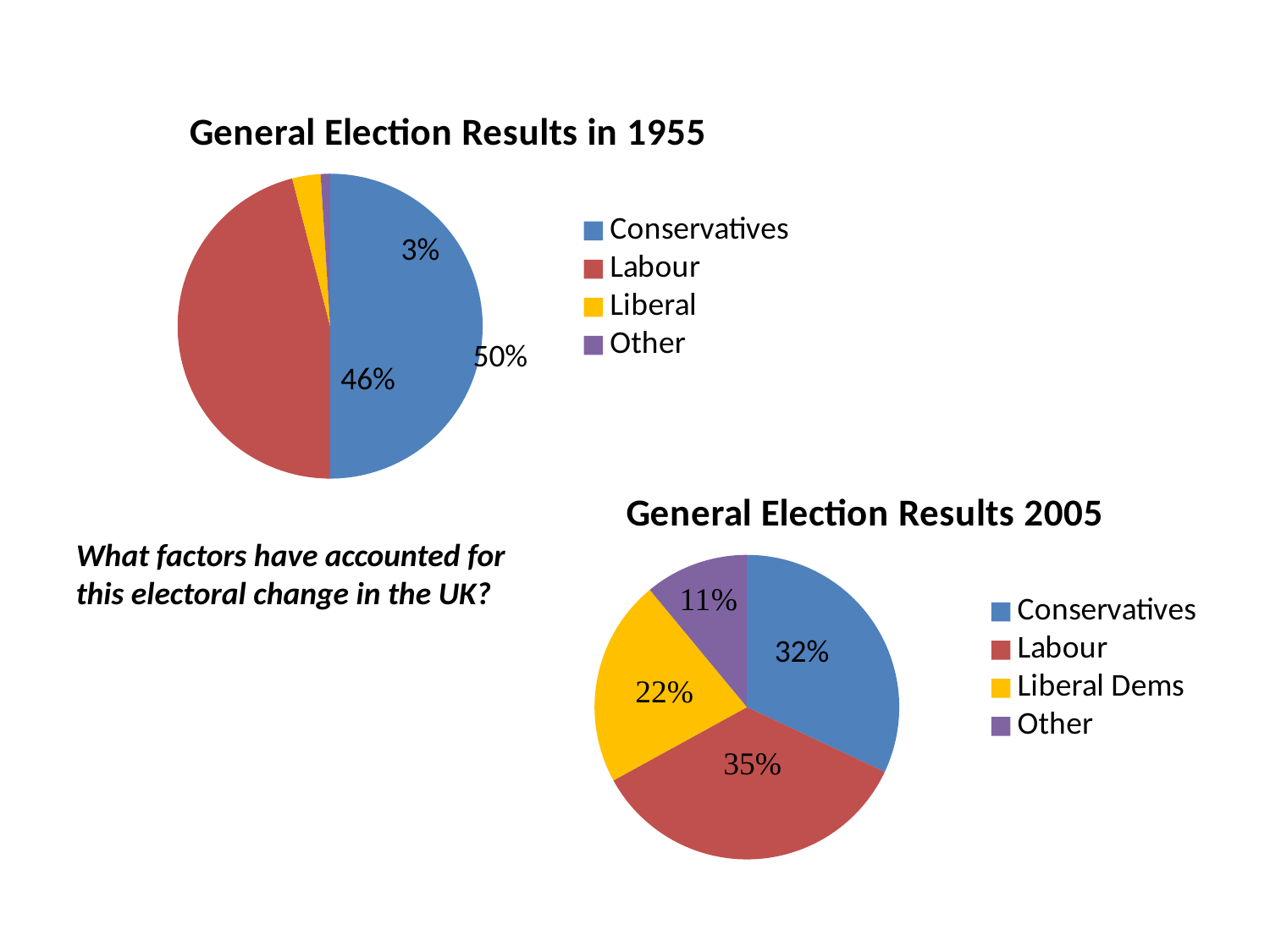
In the 'General Election Results in 1955' chart, what share did the Conservatives receive? 50% In the 'General Election Results in 1955' chart, what share did Labour receive? 46% In the 'General Election Results 2005' chart, what share did Other receive? 11% In the 'General Election Results 2005' chart, which party has the smallest slice? Other In the 'General Election Results 2005' chart, which is larger, the Conservatives' share or Labour's share? Labour In the 'General Election Results in 1955' chart, what share did the Liberal party receive? 3% What kind of chart is the 'General Election Results 2005' chart? Pie chart In the 'General Election Results 2005' chart, what share did Labour receive? 35% In the 'General Election Results 2005' chart, what share did the Liberal Dems receive? 22% How many entries does the legend of the 'General Election Results 2005' chart list? 4 In the 'General Election Results in 1955' chart, what is the difference between the Conservatives' and Labour's shares? 4% In the 'General Election Results in 1955' chart, which party has the largest slice? Conservatives